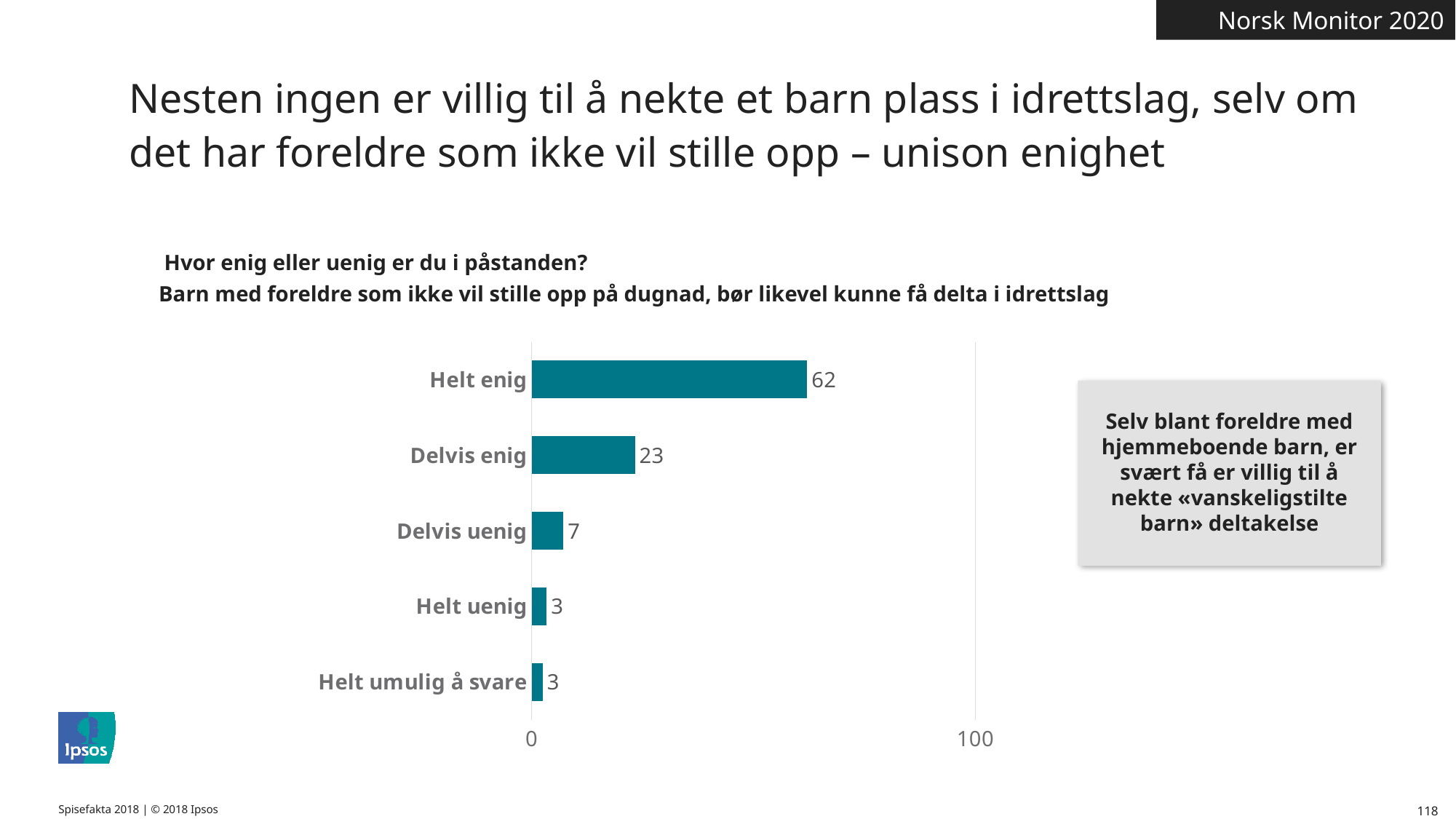
What is the value for "Delvis uenig"? 7 What is the value for "Helt uenig"? 3 What is the maximum value shown on the chart's axis? 100 What is the value for "Helt umulig å svare"? 3 What kind of chart is shown on the slide? Bar chart What is the difference between the values for "Delvis enig" and "Delvis uenig"? 16 What is the value for "Delvis enig"? 23 Which is larger, the value for "Delvis enig" or the value for "Delvis uenig"? Delvis enig Which category has the highest value? Helt enig What is the difference between the values for "Helt enig" and "Delvis enig"? 39 How many categories are shown in the chart? 5 What is the value for "Helt enig"? 62